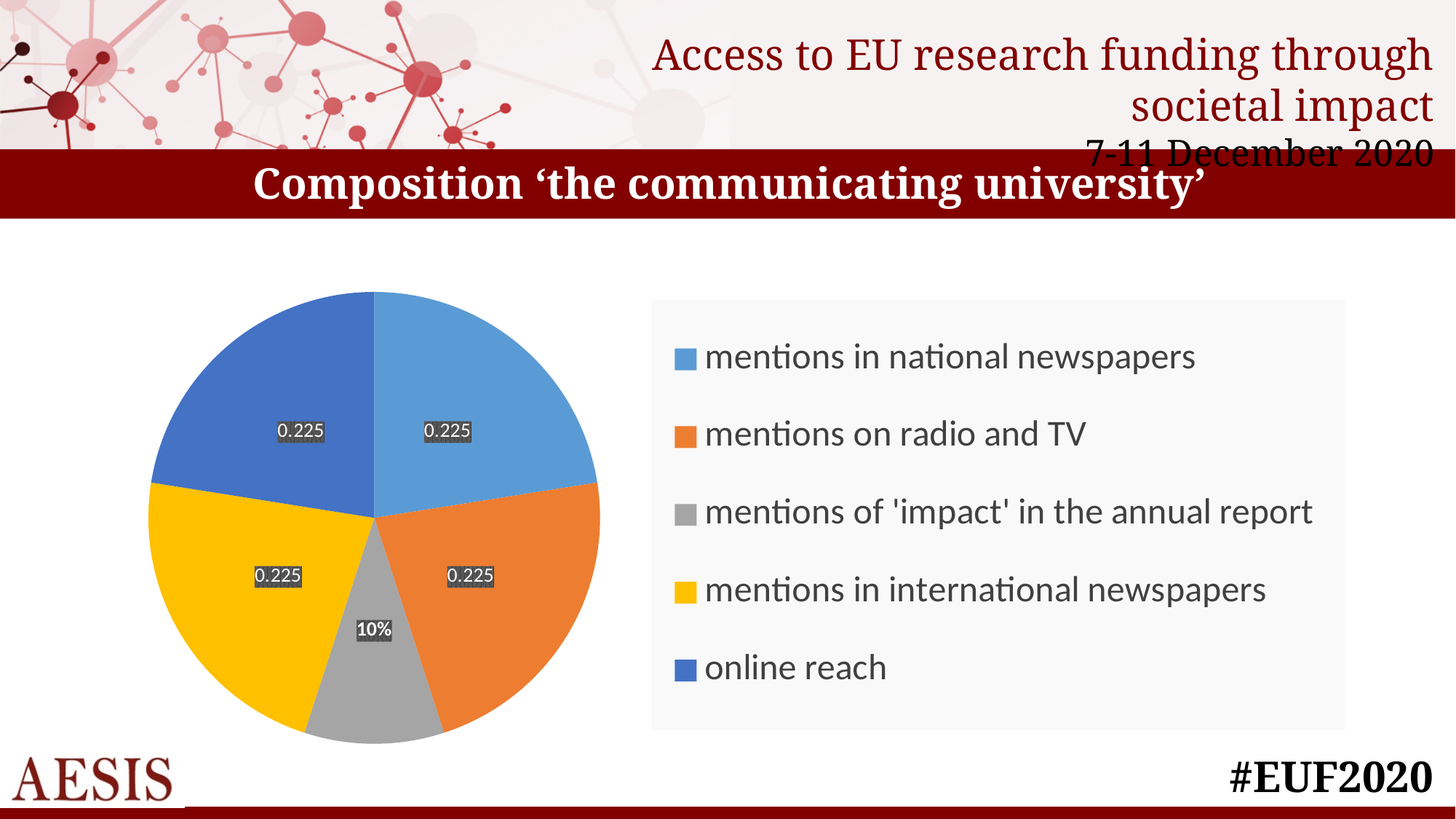
What value is shown for the 'mentions on radio and TV' slice? 0.225 Which is larger: the slice for 'online reach' or the slice for 'mentions of 'impact' in the annual report'? online reach How many slices does the pie chart have? 5 What value is shown for the 'mentions in national newspapers' slice of the pie chart? 0.225 What colour is the 'online reach' slice? dark blue What kind of chart is shown on the slide? pie chart What is the title shown in the banner above the chart? Composition 'the communicating university' What share of the pie is 'mentions of 'impact' in the annual report'? 10% What value is shown for the 'mentions in international newspapers' slice? 0.225 What value is shown for the 'online reach' slice? 0.225 Which category has the smallest slice of the pie? mentions of 'impact' in the annual report How many entries does the legend list? 5